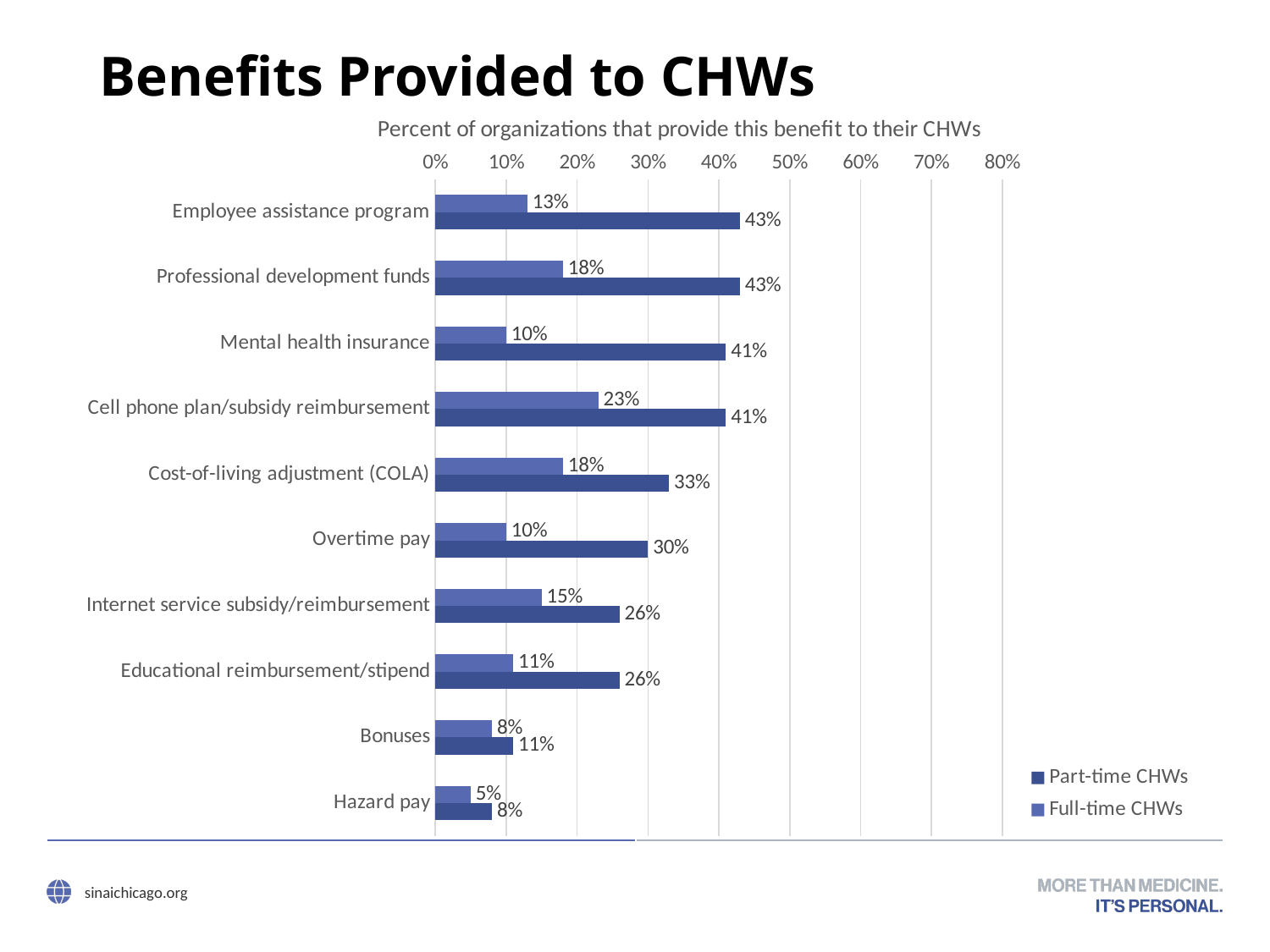
What is the subtitle shown above the chart? Percent of organizations that provide this benefit to their CHWs What percent of organizations provide a cell phone plan/subsidy reimbursement to full-time CHWs? 23% Which is larger: the full-time CHW value for professional development funds or the full-time CHW value for bonuses? Professional development funds Which benefit has the highest value for full-time CHWs? Cell phone plan/subsidy reimbursement What percent of organizations provide overtime pay to part-time CHWs? 30% How many benefit categories are shown in the chart? 10 Is the part-time CHW value for cost-of-living adjustment (COLA) greater or less than 40%? less How many series does the legend list? 2 Which benefit has the lowest value for part-time CHWs? Hazard pay What is the difference between the part-time and full-time CHW values for mental health insurance? 31% What is the value for hazard pay for full-time CHWs? 5% What type of chart is shown on the slide? bar chart